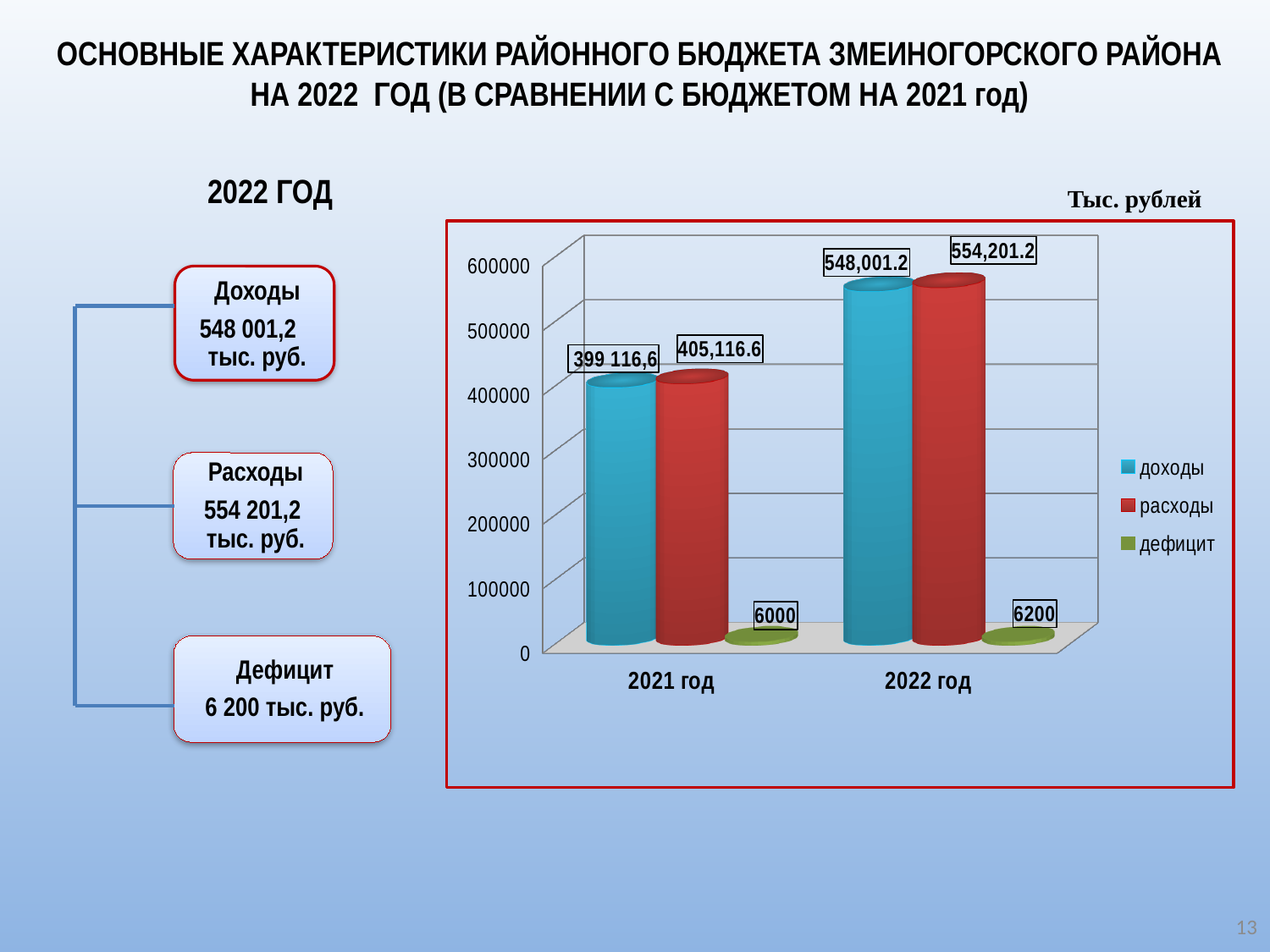
What is the difference between расходы and доходы for 2022 год? 6,200 What is the value of доходы for 2021 год? 399 116,6 What is the value of дефицит for 2021 год? 6000 What is the value of доходы for 2022 год? 548,001.2 Which series has the highest value in 2021 год? расходы What is the difference between дефицит in 2022 год and дефицит in 2021 год? 200 What is the value of расходы for 2022 год? 554,201.2 Does the value of доходы rise or fall from 2021 год to 2022 год? rise Which series has the lowest value in 2022 год? дефицит What kind of chart is shown on the slide? bar chart How many series does the legend list? 3 Which is larger: доходы in 2022 год or доходы in 2021 год? доходы in 2022 год